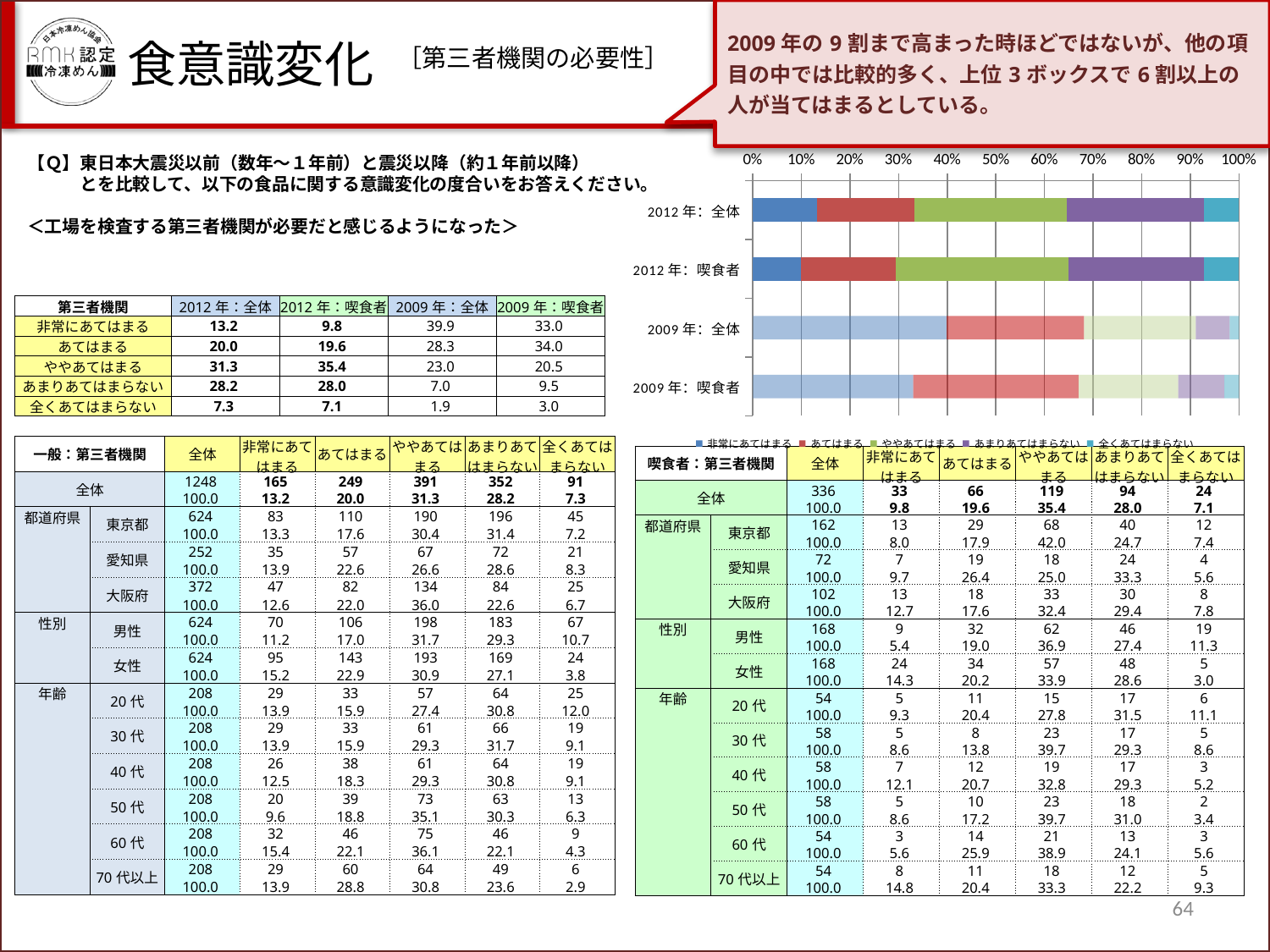
What is the highest value shown on the chart's x axis? 100% How many series does the chart legend list? 5 In the chart, which is larger: the 非常にあてはまる segment for 2009年:喫食者 or for 2012年:喫食者? 2009年:喫食者 In the chart, is the 非常にあてはまる segment for 2012年:全体 greater or less than 20%? less In the chart, which category has the smallest 非常にあてはまる segment? 2012年:喫食者 In the chart, which category has the largest ややあてはまる segment? 2012年:喫食者 What kind of chart is shown on the right side of the slide? stacked bar chart In the chart, which category has the largest 非常にあてはまる segment? 2009年:全体 In the chart, is the 非常にあてはまる segment for 2009年:全体 greater or less than 30%? greater How many bars (categories) does the chart on the right show? 4 What is the first series listed in the chart legend? 非常にあてはまる